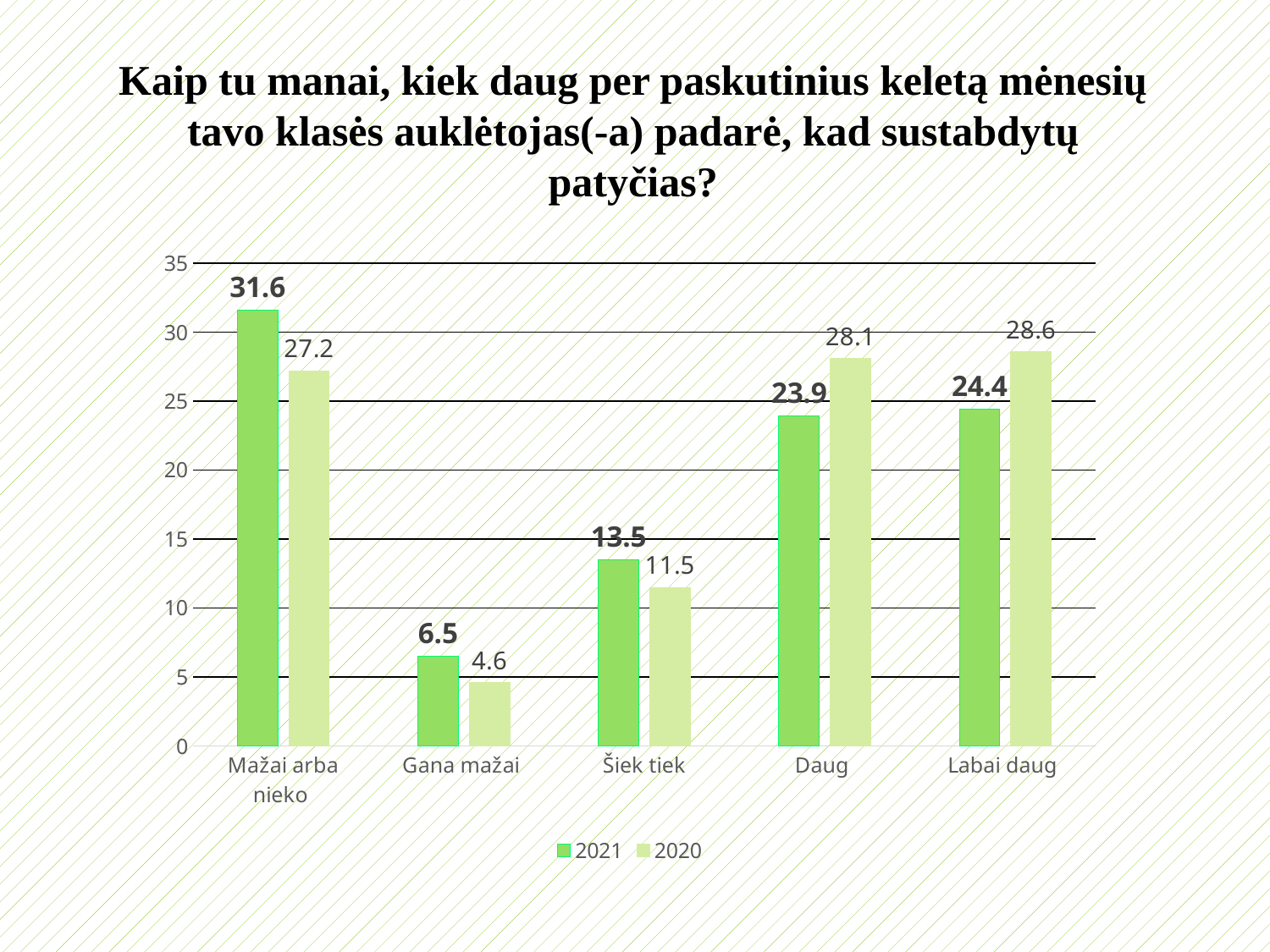
Which category has the lowest 2020 value? Gana mažai What is the difference between the 2021 and 2020 values for "Šiek tiek"? 2 What is the 2021 value for "Mažai arba nieko"? 31.6 Which is larger for "Labai daug": the 2021 value or the 2020 value? 2020 How many series does the legend list? 2 Which category has the highest 2021 value? Mažai arba nieko What kind of chart is shown on the slide? Bar chart What is the 2020 value for "Gana mažai"? 4.6 What is the 2020 value for "Daug"? 28.1 How many categories are shown on the x axis? 5 Which series is shown in the darker green colour? 2021 What is the 2021 value for "Labai daug"? 24.4